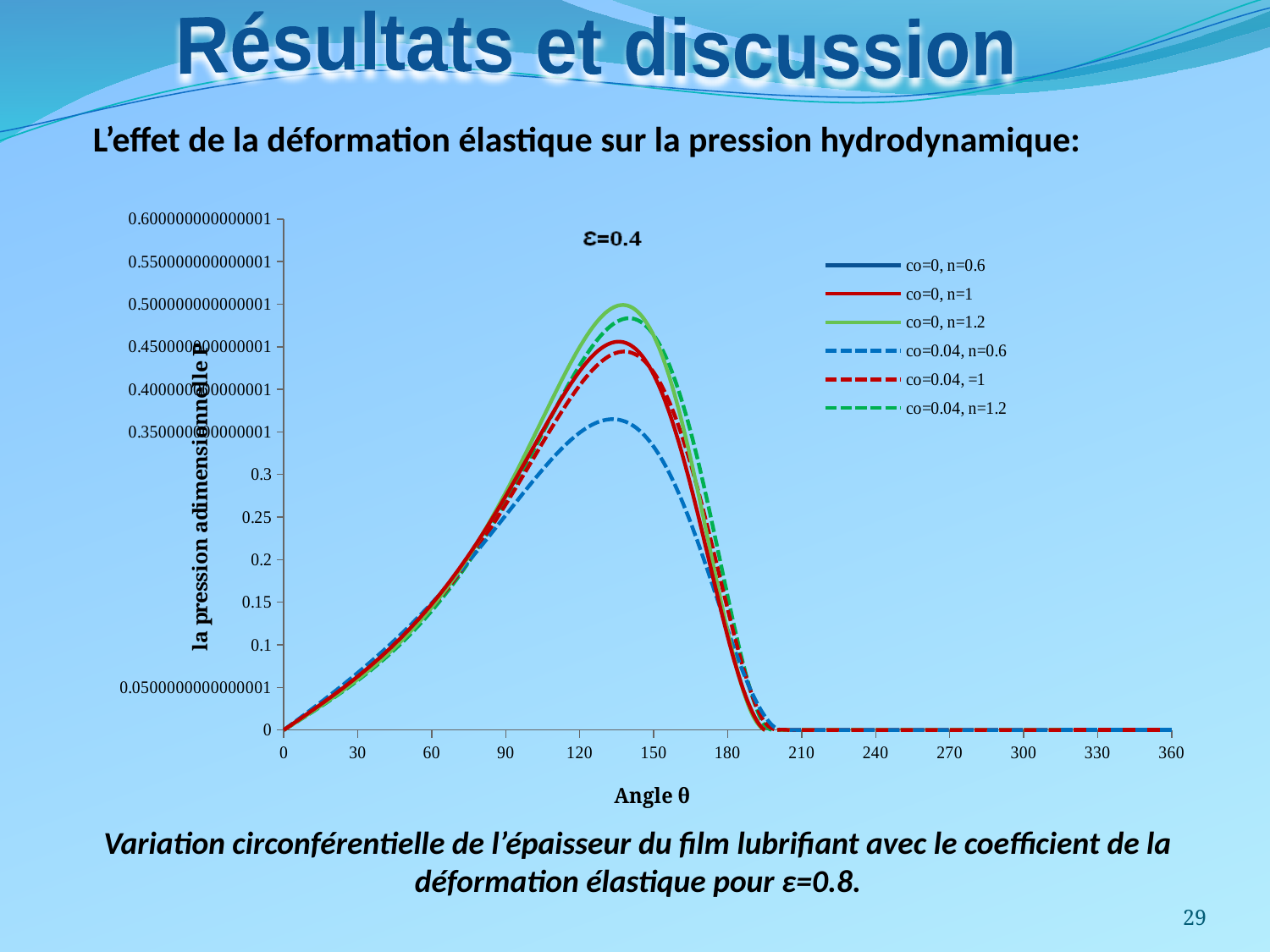
How do the pressure values change as the angle increases from 0 to 180? they rise to a peak then fall How many series does the legend list? 6 What is the title of the x axis? Angle θ Is the peak value of the co=0, n=1 series greater or less than 0.5? less Which series reaches the highest peak pressure? co=0, n=1.2 Is the peak value of the co=0.04, n=0.6 series greater or less than 0.4? less What title is printed inside the chart area? ε=0.4 Is the peak value of the co=0, n=1.2 series greater or less than 0.45? greater What kind of chart is shown on the slide? line chart What is the value of the co=0, n=1 series at an angle of 300? 0 Which series has the lowest peak pressure? co=0.04, n=0.6 Which series has the higher peak, co=0, n=1 or co=0.04, n=0.6? co=0, n=1